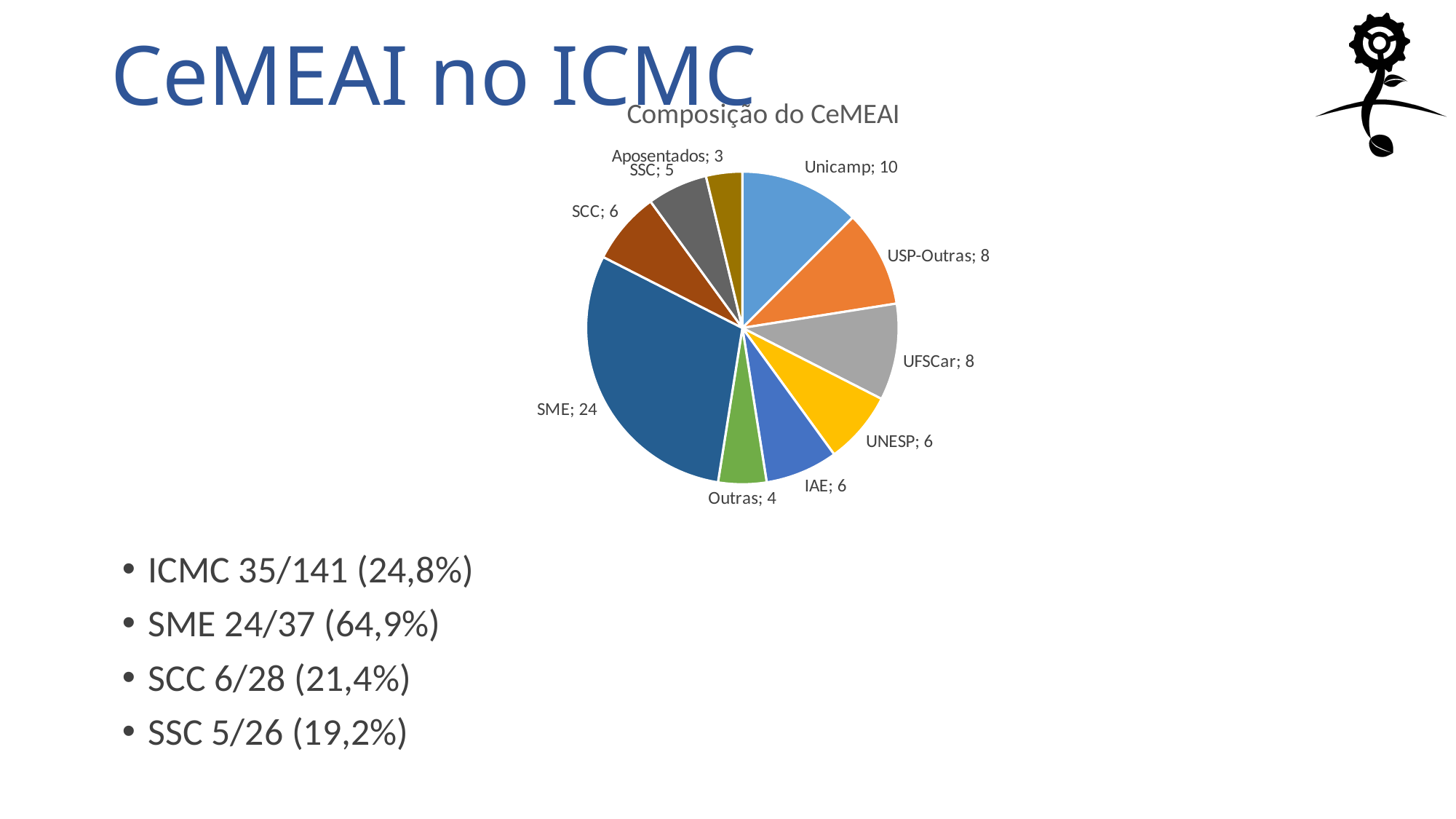
Which is larger, the value for SCC or the value for SSC? SCC What is the title of the chart? Composição do CeMEAI Which category has the smallest slice in the pie chart? Aposentados What is the difference between the values for SME and Unicamp? 14 What share of the pie does the SME slice represent? 30% What is the value for Unicamp in the pie chart? 10 What is the value for Aposentados in the pie chart? 3 What kind of chart is shown on the slide? pie chart How many categories are shown in the pie chart? 10 Which category has the largest slice in the pie chart? SME What is the value for SME in the pie chart? 24 What is the total of all the values in the pie chart? 80